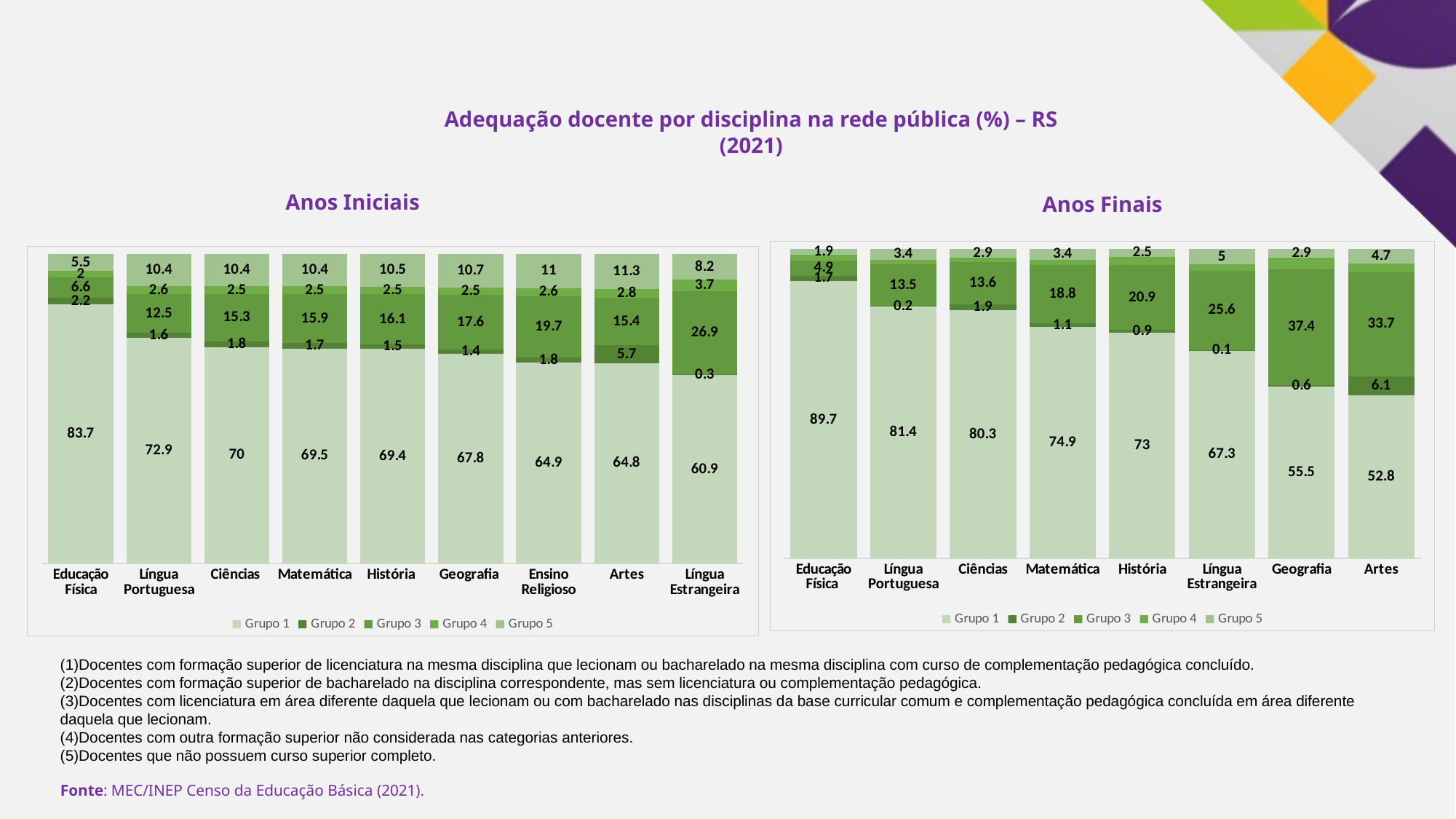
In the Anos Iniciais chart, do the Grupo 1 values rise or fall from left to right across the disciplines? Fall How many disciplines are shown in the Anos Iniciais chart? 9 How many disciplines are shown in the Anos Finais chart? 8 In the Anos Finais chart, what is the difference between the Grupo 1 values for Educação Física and Artes? 36.9 In the Anos Finais chart, what is the Grupo 3 value for Geografia? 37.4 How many series does the legend of the Anos Finais chart list? 5 In the Anos Iniciais chart, what is the Grupo 1 value for Educação Física? 83.7 In the Anos Iniciais chart, what is the total of the stacked bar for Artes? 100 In the Anos Iniciais chart, which has the larger Grupo 3 value: Língua Estrangeira or Ensino Religioso? Língua Estrangeira In the Anos Finais chart, which discipline has the lowest Grupo 1 value? Artes In the Anos Iniciais chart, which discipline has the highest Grupo 1 value? Educação Física What kind of chart is used for the Anos Iniciais data? Stacked bar chart